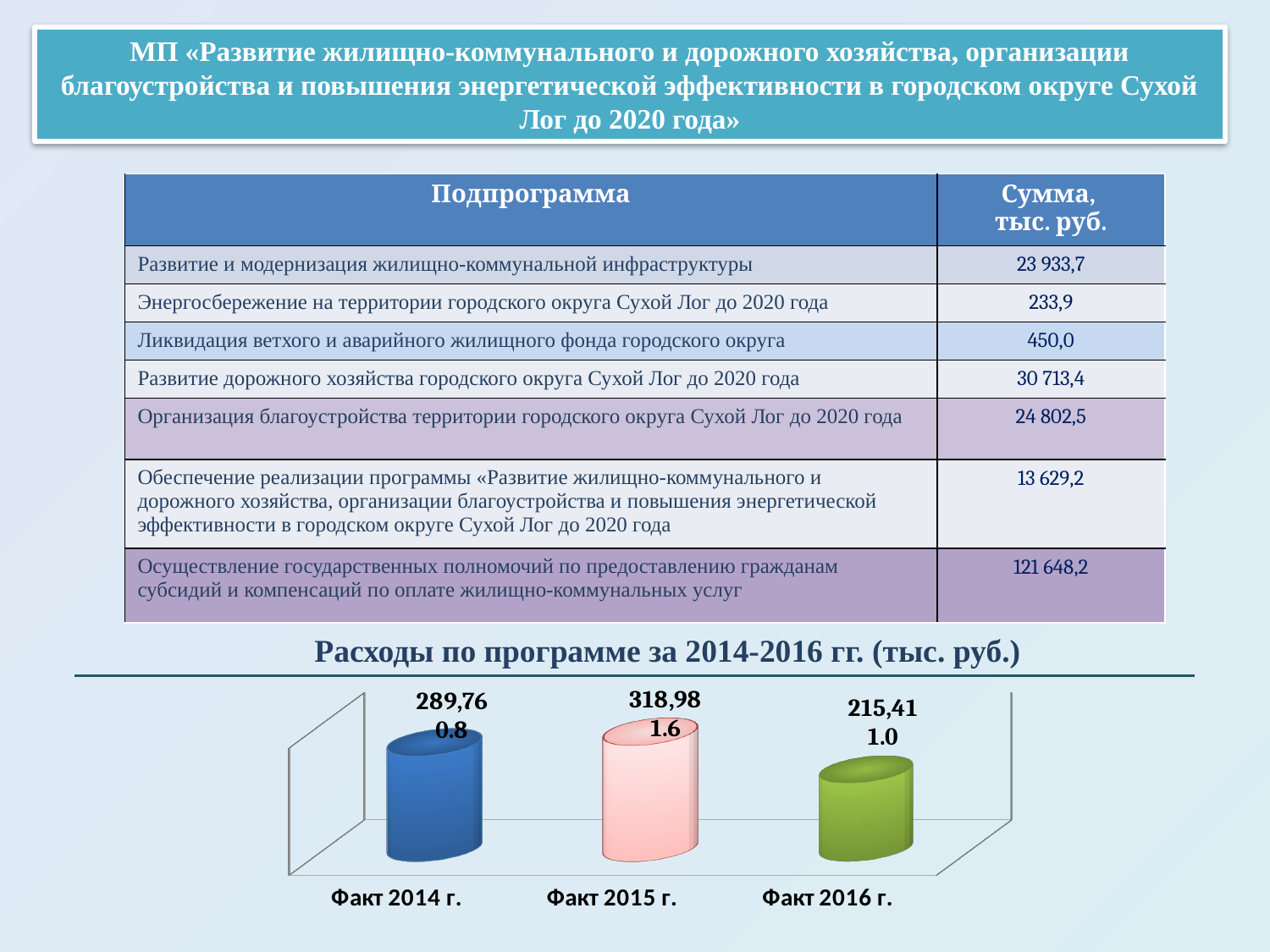
What kind of chart is shown on the slide? Bar chart What is the value shown for Факт 2016 г. in the chart? 215,411.0 What is the difference between the values for Факт 2014 г. and Факт 2016 г.? 74,349.8 What is the value shown for Факт 2014 г. in the chart? 289,760.8 Which year has the highest value in the chart? Факт 2015 г. What is the difference between the values for Факт 2015 г. and Факт 2014 г.? 29,220.8 What is the difference between the values for Факт 2015 г. and Факт 2016 г.? 103,570.6 How many categories are plotted in the chart? 3 What is the title of the chart? Расходы по программе за 2014-2016 гг. (тыс. руб.) Which is larger, the value for Факт 2014 г. or the value for Факт 2016 г.? Факт 2014 г. What is the value shown for Факт 2015 г. in the chart? 318,981.6 Which year has the lowest value in the chart? Факт 2016 г.